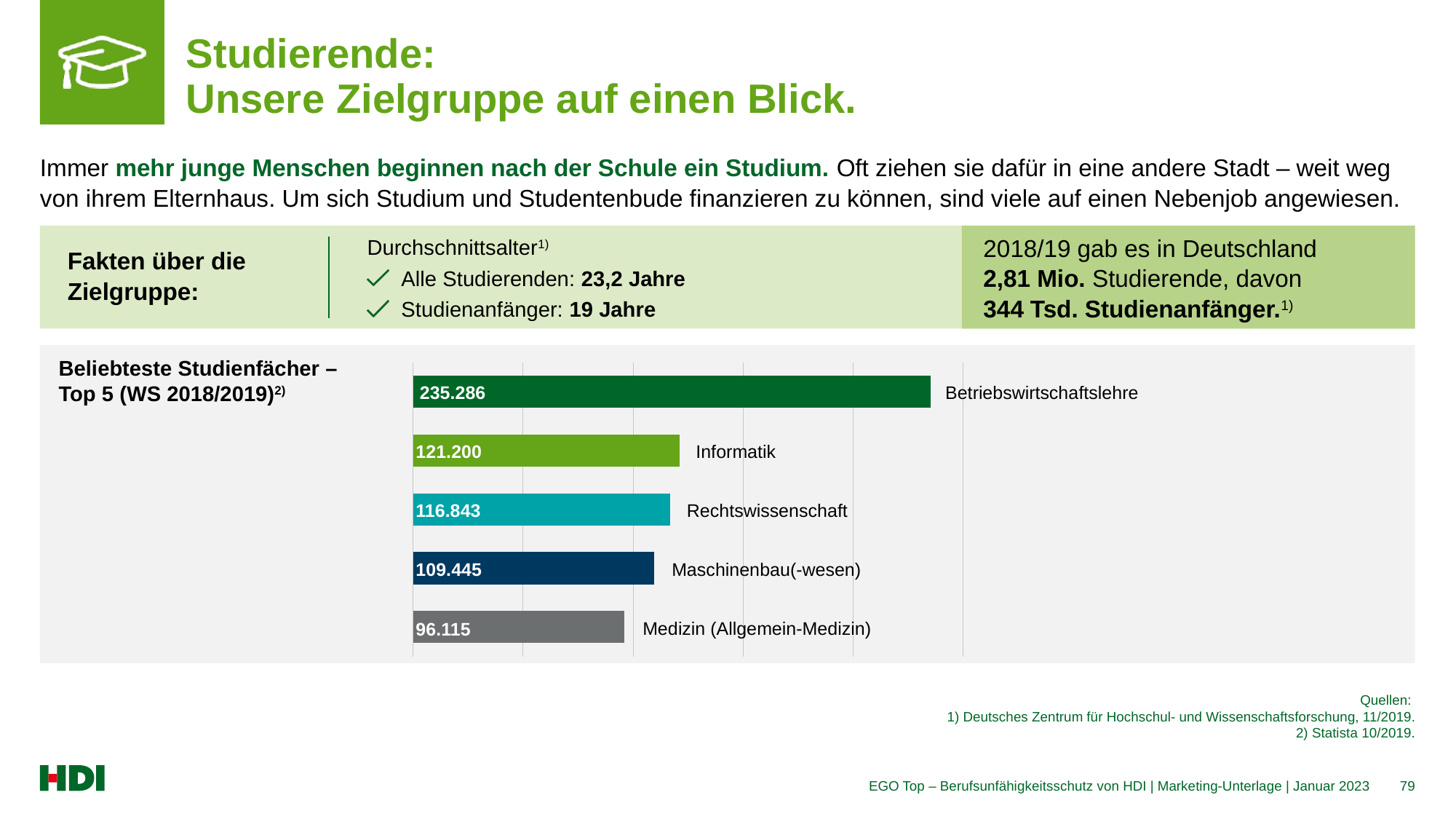
How many subjects are shown in the chart? 5 What is the value for Medizin (Allgemein-Medizin) in the chart? 96.115 What is the title of the chart? Beliebteste Studienfächer – Top 5 (WS 2018/2019) What is the difference between the values for Maschinenbau(-wesen) and Medizin (Allgemein-Medizin)? 13.330 What is the value for Rechtswissenschaft in the chart? 116.843 What type of chart is shown on the slide? Bar chart Which subject has the highest value in the chart? Betriebswirtschaftslehre Which has a larger value, Informatik or Rechtswissenschaft? Informatik Which subject has the lowest value in the chart? Medizin (Allgemein-Medizin) What is the value for Betriebswirtschaftslehre in the chart? 235.286 What is the value for Informatik in the chart? 121.200 What is the difference between the values for Betriebswirtschaftslehre and Informatik? 114.086